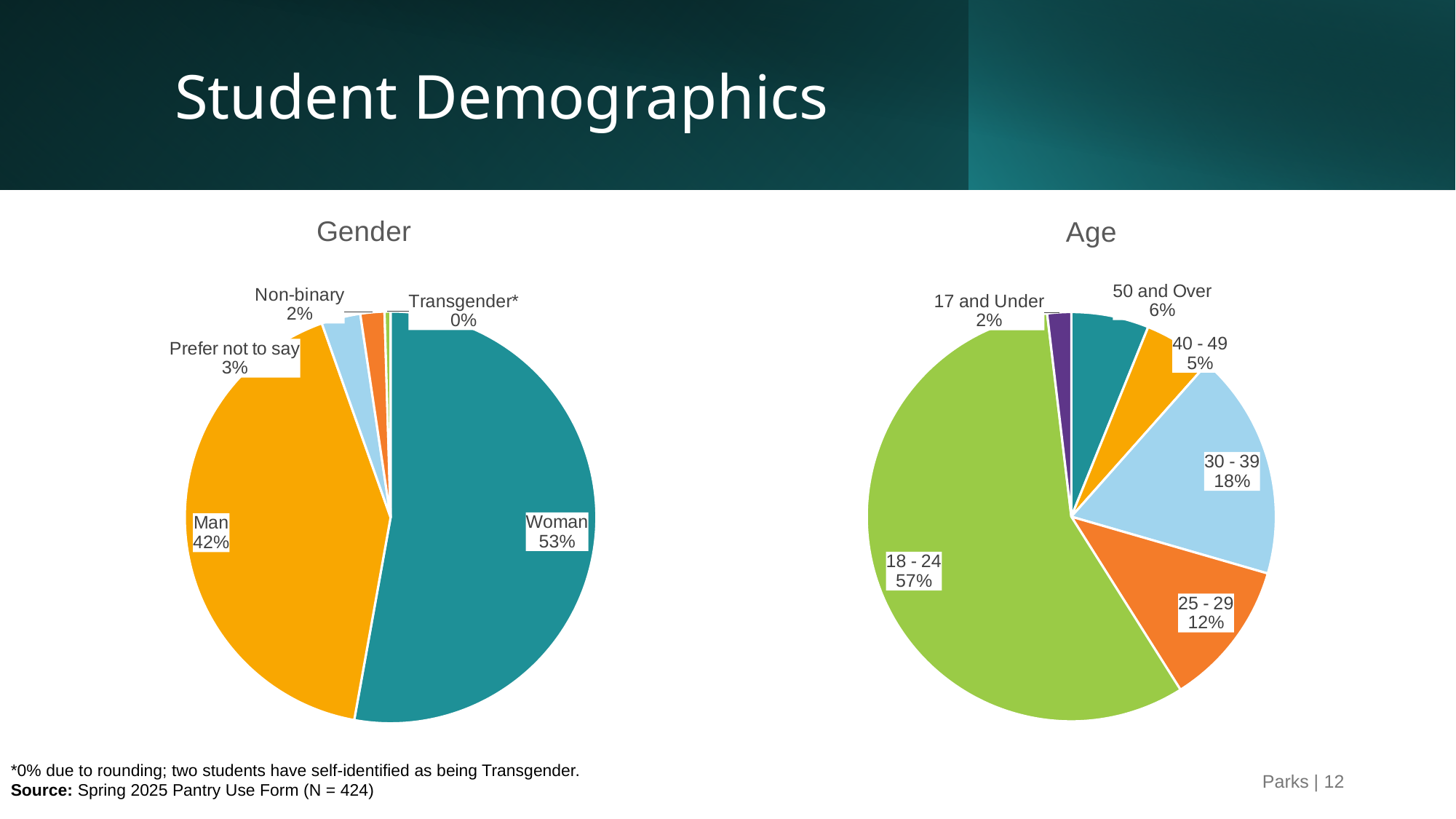
In the Age chart, what share of students are 18 - 24? 57% In the Gender chart, what percentage is shown for Man? 42% In the Gender chart, what share of students are Woman? 53% What type of chart is the Age chart? Pie chart In the Gender chart, how many categories are shown? 5 In the Age chart, which age group has the smallest slice? 17 and Under In the Gender chart, what is the difference between the Woman and Man percentages? 11% In the Gender chart, which category has the largest slice? Woman In the Gender chart, what percentage is shown for Prefer not to say? 3% In the Age chart, which is larger, 30 - 39 or 25 - 29? 30 - 39 In the Age chart, how many age groups are shown? 6 In the Age chart, what is the difference between the 30 - 39 and 25 - 29 percentages? 6%